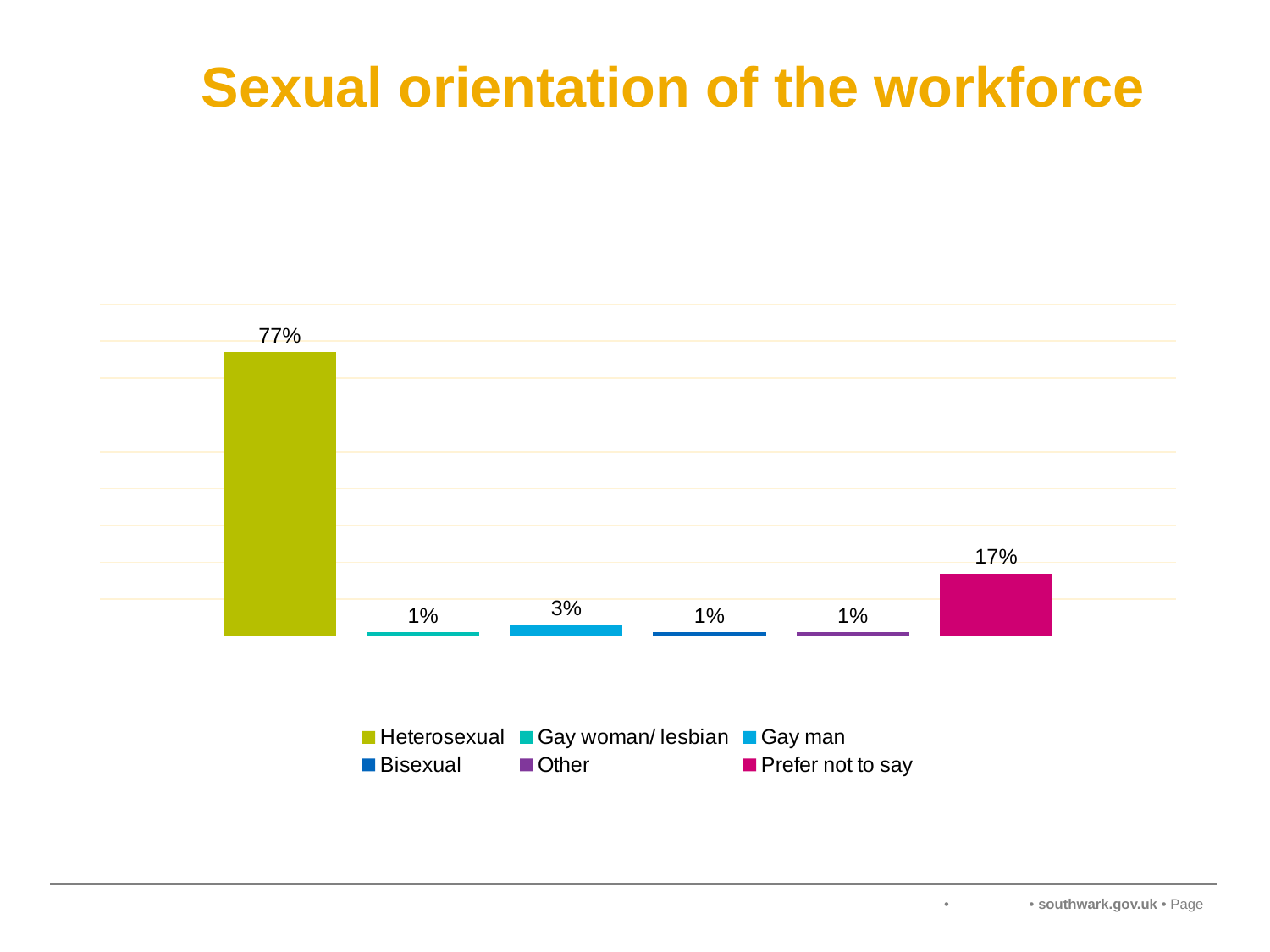
What percentage of the workforce is Gay man? 3% What percentage of the workforce chose Prefer not to say? 17% Which is larger, the value for Gay man or the value for Other? Gay man How many bars are plotted on the chart? 6 How many entries does the legend list? 6 What percentage of the workforce is Gay woman/ lesbian? 1% What percentage of the workforce is Bisexual? 1% What percentage of the workforce is Heterosexual? 77% Which category has the highest value? Heterosexual What type of chart is shown on the slide? Bar chart What is the difference between the Gay man value and the Bisexual value? 2% What is the difference between the Heterosexual value and the Prefer not to say value? 60%